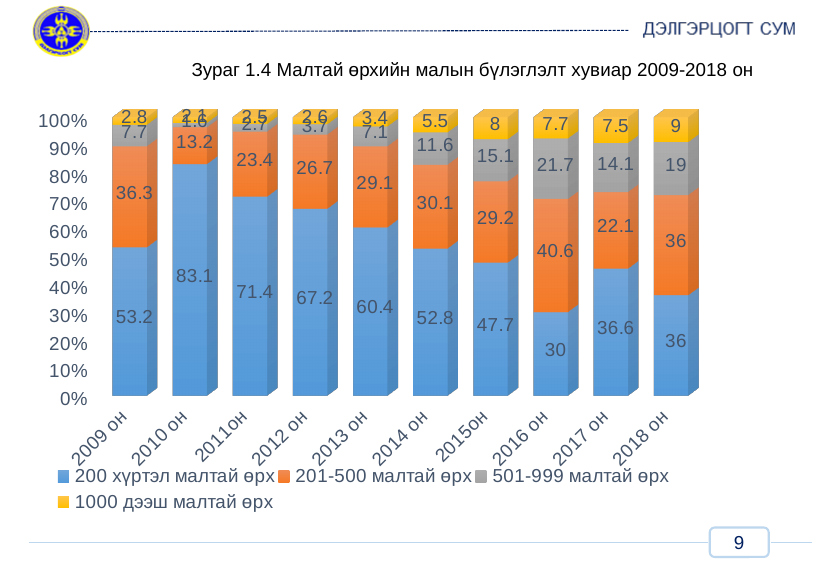
What is the value for "201-500 малтай өрх" in 2016 он? 40.6 What is the value for "501-999 малтай өрх" in 2018 он? 19 What is the value for "200 хүртэл малтай өрх" in 2010 он? 83.1 How many years are shown on the x axis? 10 What is the value for "1000 дээш малтай өрх" in 2014 он? 5.5 What is the difference between the "200 хүртэл малтай өрх" values for 2009 он and 2018 он? 17.2 In which year is the value for "200 хүртэл малтай өрх" highest? 2010 он In which year is the value for "200 хүртэл малтай өрх" lowest? 2016 он What kind of chart is shown on the slide? Stacked bar chart Which is larger: the "501-999 малтай өрх" value in 2016 он or in 2017 он? 2016 он Does the value for "1000 дээш малтай өрх" generally rise or fall from 2011 он to 2018 он? Rise How many series does the legend list? 4